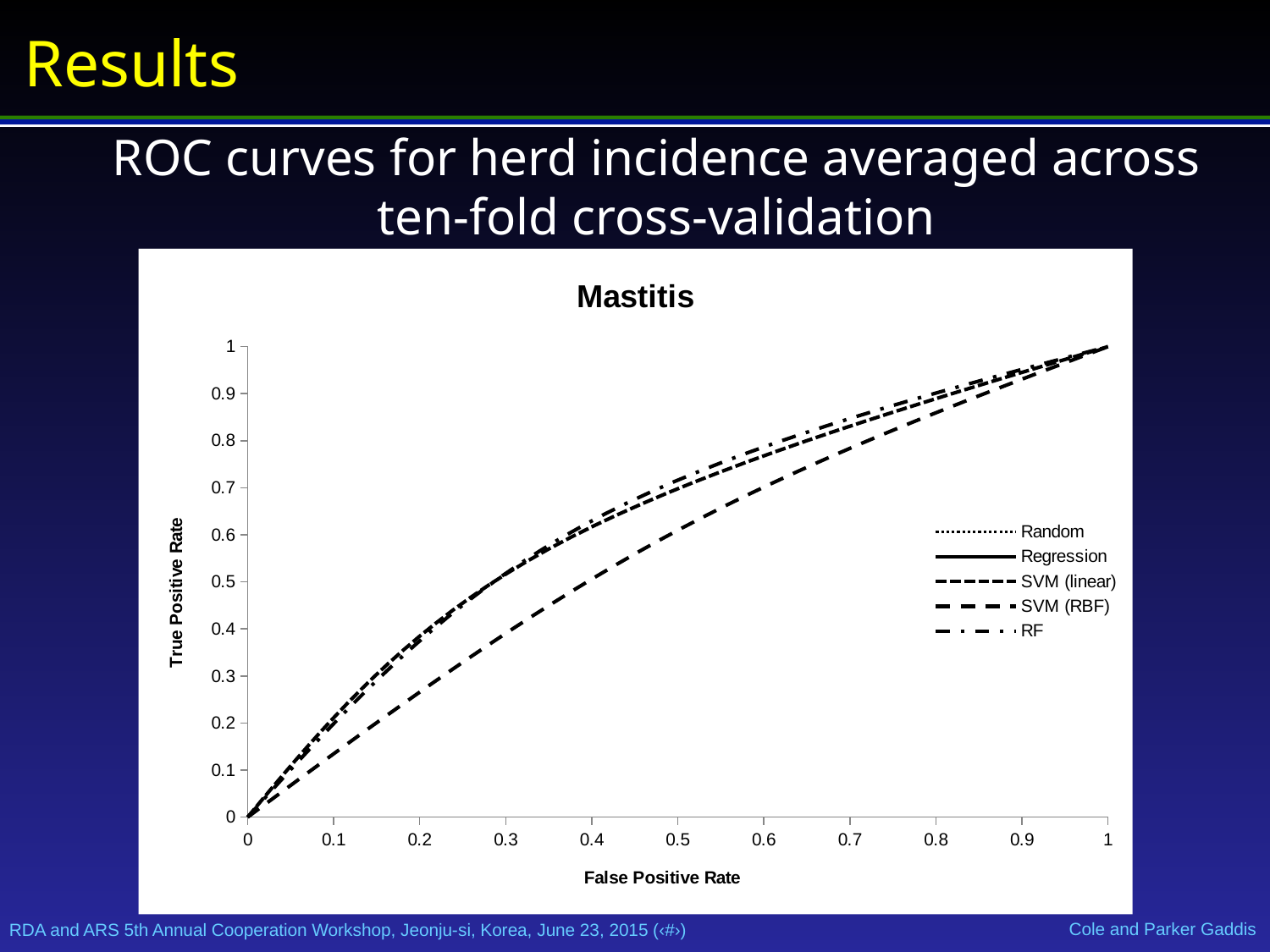
Do the curves in the Mastitis chart rise or fall as the False Positive Rate increases? rise What is the label of the y axis of the Mastitis chart? True Positive Rate How many series does the legend of the Mastitis chart list? 5 What kind of chart is shown on the slide? line chart What is the highest value shown on the x axis of the Mastitis chart? 1 What True Positive Rate do all the curves in the Mastitis chart reach at a False Positive Rate of 1? 1 What is the title of the chart on the slide? Mastitis At a False Positive Rate of 0.3, is the True Positive Rate of the highest curve in the Mastitis chart greater or less than 0.7? less At a False Positive Rate of 0.5, is the True Positive Rate of the lowest curve in the Mastitis chart greater or less than 0.4? greater At a False Positive Rate of 0.1, is the True Positive Rate of the lowest curve in the Mastitis chart greater or less than 0.3? less How many tick marks are labelled on the x axis of the Mastitis chart? 11